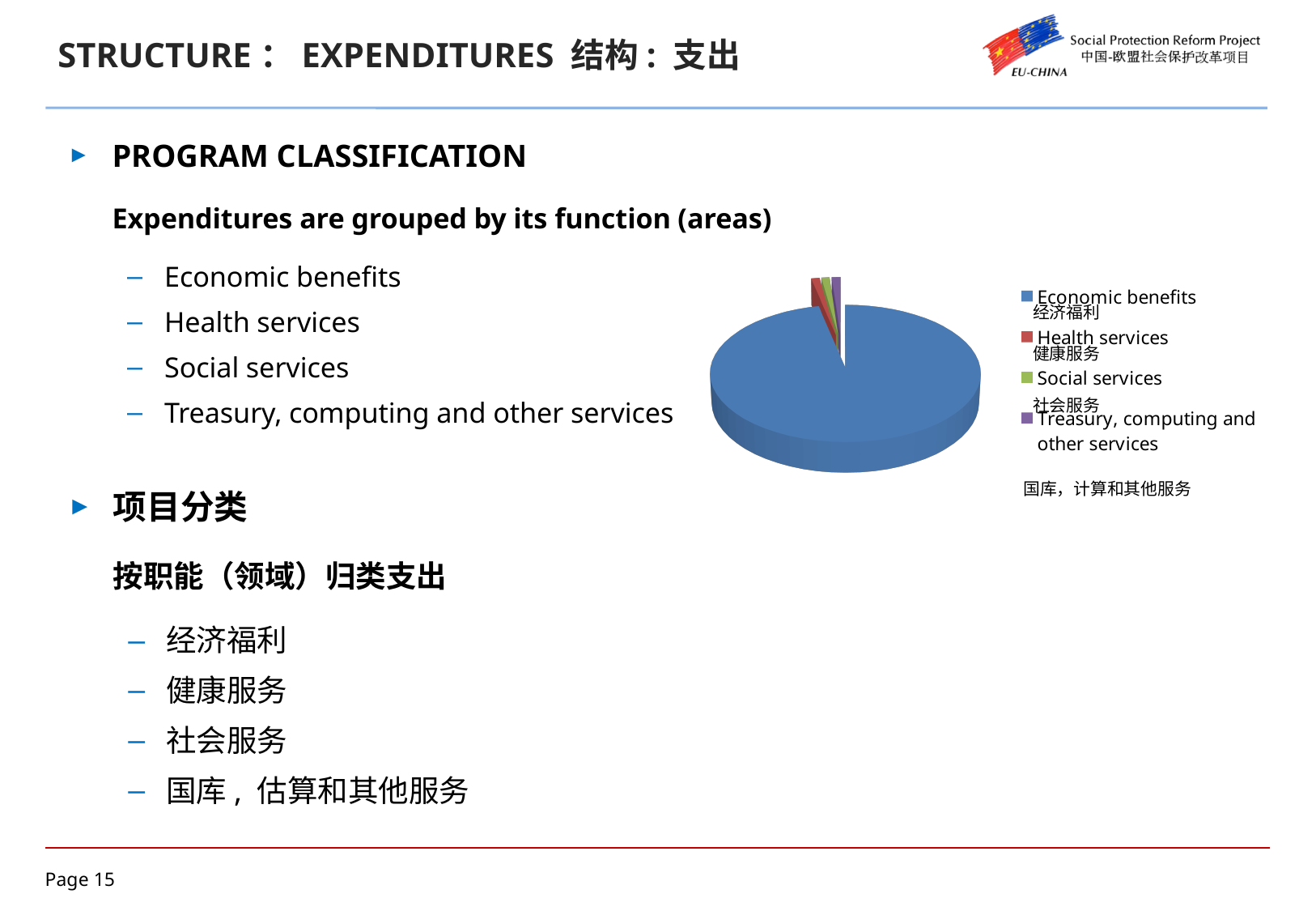
Which category has the largest slice in the pie chart? Economic benefits What colour is the Economic benefits slice in the pie chart? blue Which slice is larger in the pie chart, Economic benefits or Health services? Economic benefits Which legend entry in the pie chart is shown in purple? Treasury, computing and other services What kind of chart is shown on the slide? pie chart Which slice is larger in the pie chart, Economic benefits or Treasury, computing and other services? Economic benefits How many entries does the legend of the pie chart list? 4 Which slice is larger in the pie chart, Social services or Economic benefits? Economic benefits How many categories does the pie chart show? 4